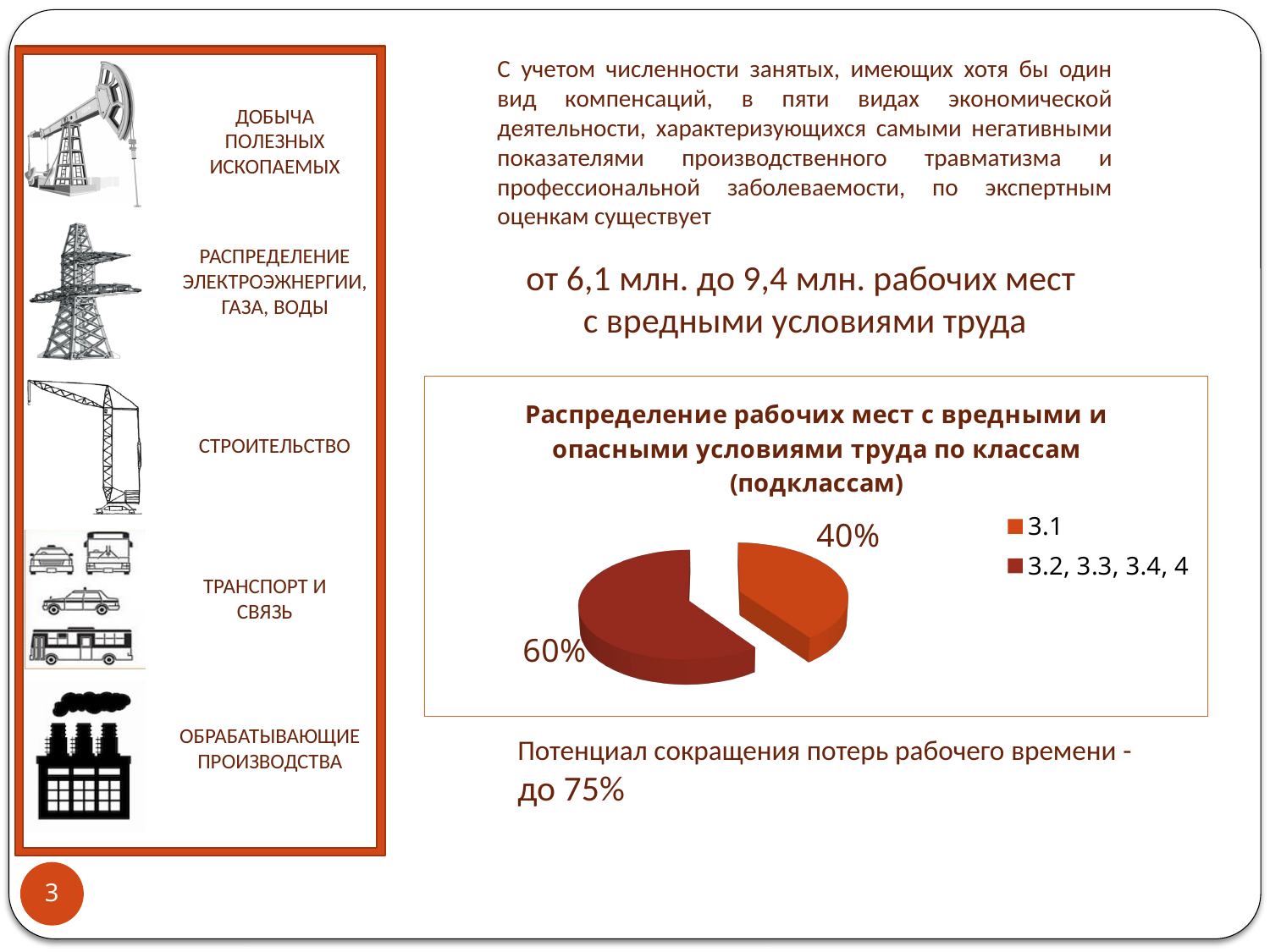
What kind of chart is shown on the slide? pie chart Which legend entry is shown in the darker red colour? 3.2, 3.3, 3.4, 4 Which slice of the pie is the smallest? 3.1 How many slices does the pie chart have? 2 How many entries does the chart legend list? 2 What is the difference in percentage points between the slice for 3.2, 3.3, 3.4, 4 and the slice for 3.1? 20% Which is larger: the share for 3.1 or the share for 3.2, 3.3, 3.4, 4? 3.2, 3.3, 3.4, 4 Which slice of the pie is the largest? 3.2, 3.3, 3.4, 4 What share of the pie does class 3.1 have? 40% Is the share for class 3.1 greater or less than 50%? less What is the title of the pie chart? Распределение рабочих мест с вредными и опасными условиями труда по классам (подклассам) What share of the pie does the slice for classes 3.2, 3.3, 3.4, 4 have? 60%